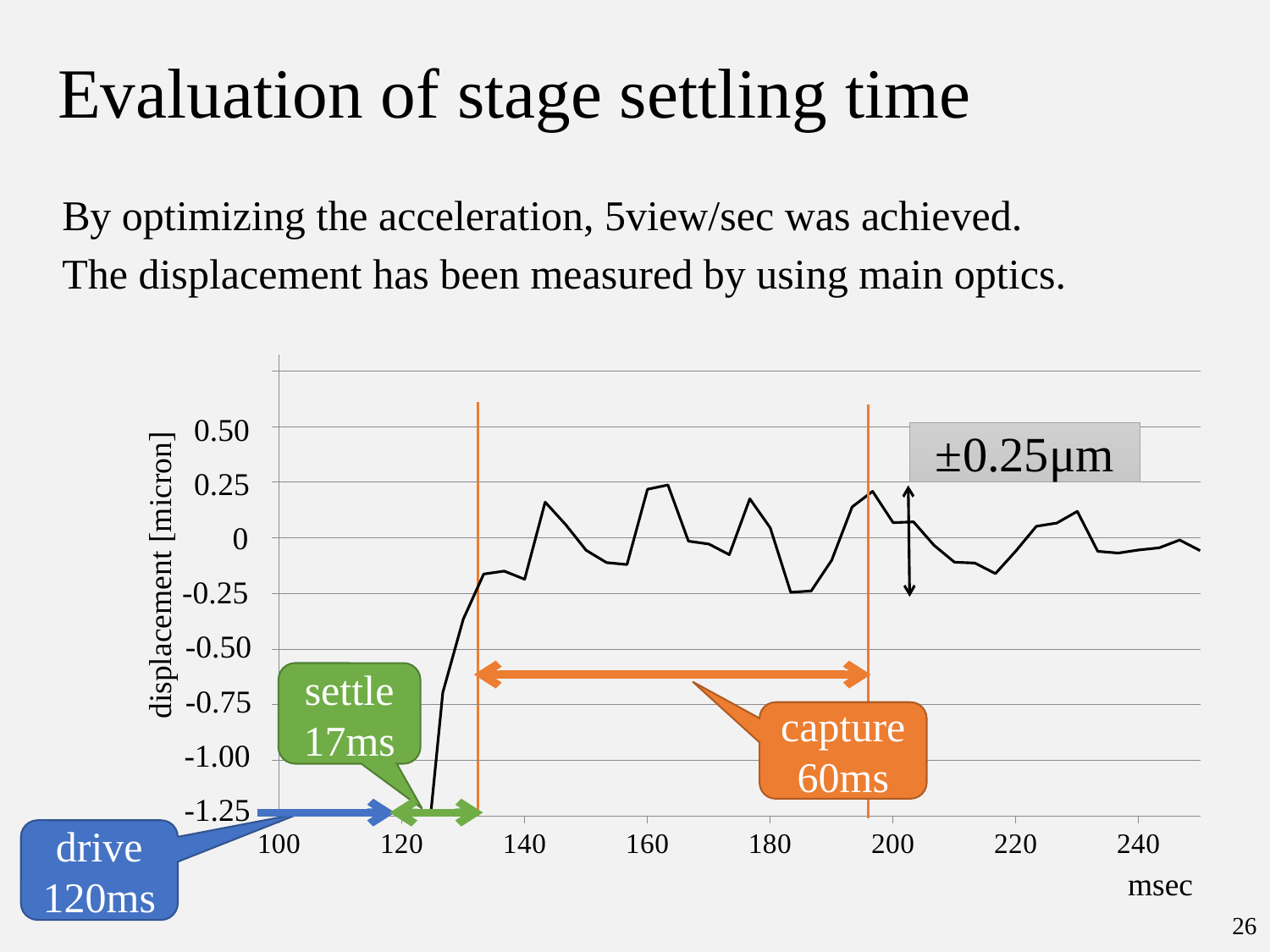
Is the displacement at 120 msec greater or less than -1.00? less Is the displacement at 140 msec greater or less than -0.50? greater Is the displacement at 160 msec greater or less than 0? greater According to the annotation on the chart, how long is the drive phase? 120ms According to the annotation on the chart, how long is the capture phase? 60ms What displacement range is indicated by the annotation during the capture phase? ±0.25µm Does the displacement rise or fall between 120 msec and 135 msec? rise According to the annotation on the chart, how long is the settle phase? 17ms What is the displacement value at 100 msec? -1.25 What unit is shown for the horizontal axis of the chart? msec What is the label of the vertical axis of the chart? displacement [micron] What kind of chart is shown on the slide? line chart